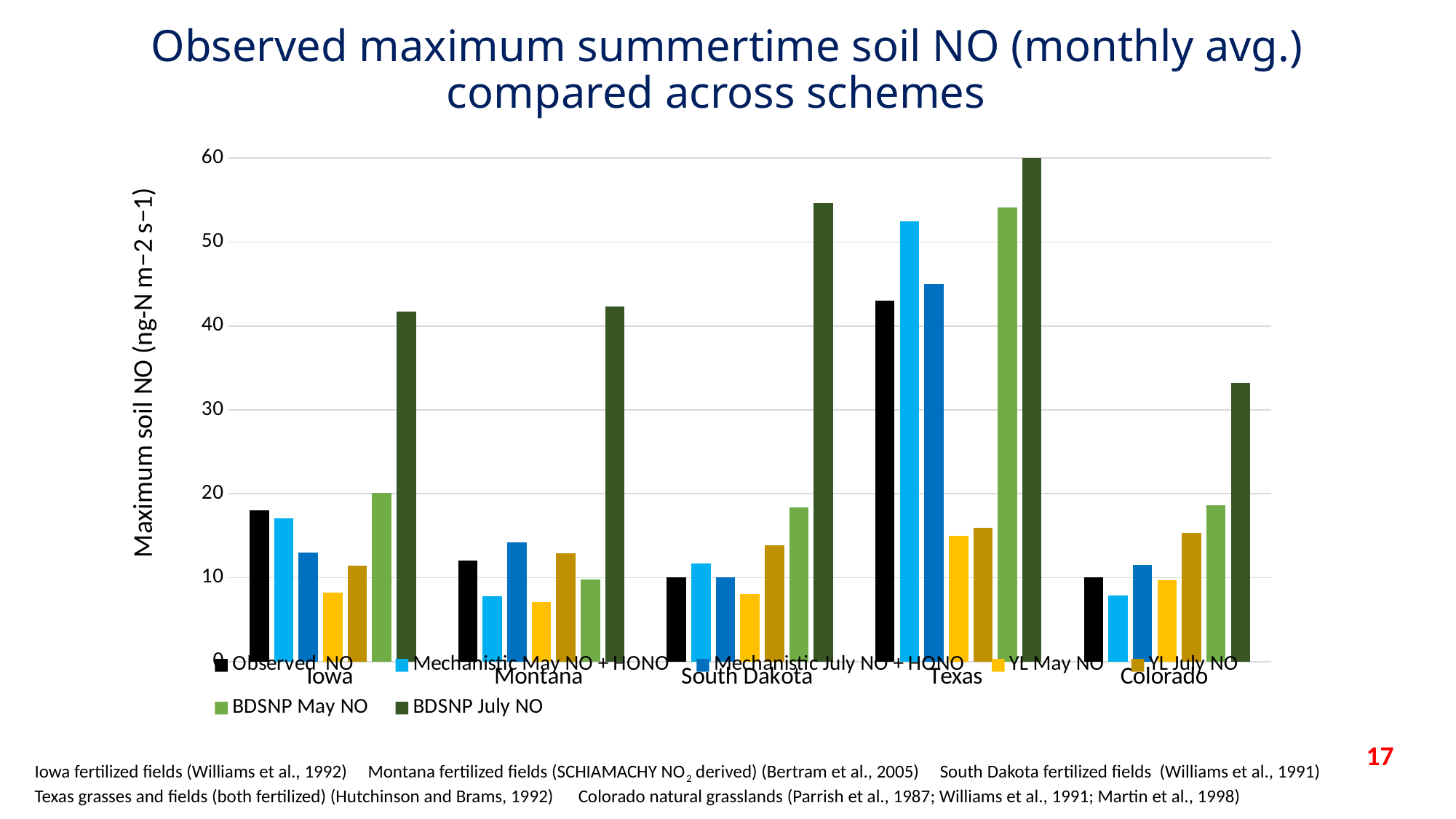
For Texas, which is larger: Mechanistic May NO + HONO or Mechanistic July NO + HONO? Mechanistic May NO + HONO Is the Observed NO value for Iowa greater or less than 20? less Is the BDSNP July NO value for Colorado greater or less than 30? greater Is the Mechanistic May NO + HONO value for Texas greater or less than 50? greater Which series has the highest value for Texas? BDSNP July NO What kind of chart is shown on the slide? bar chart Which state has the highest Observed NO value? Texas How many states (categories) are shown on the x axis? 5 What is the label of the y axis? Maximum soil NO (ng-N m−2 s−1) How many series does the legend list? 7